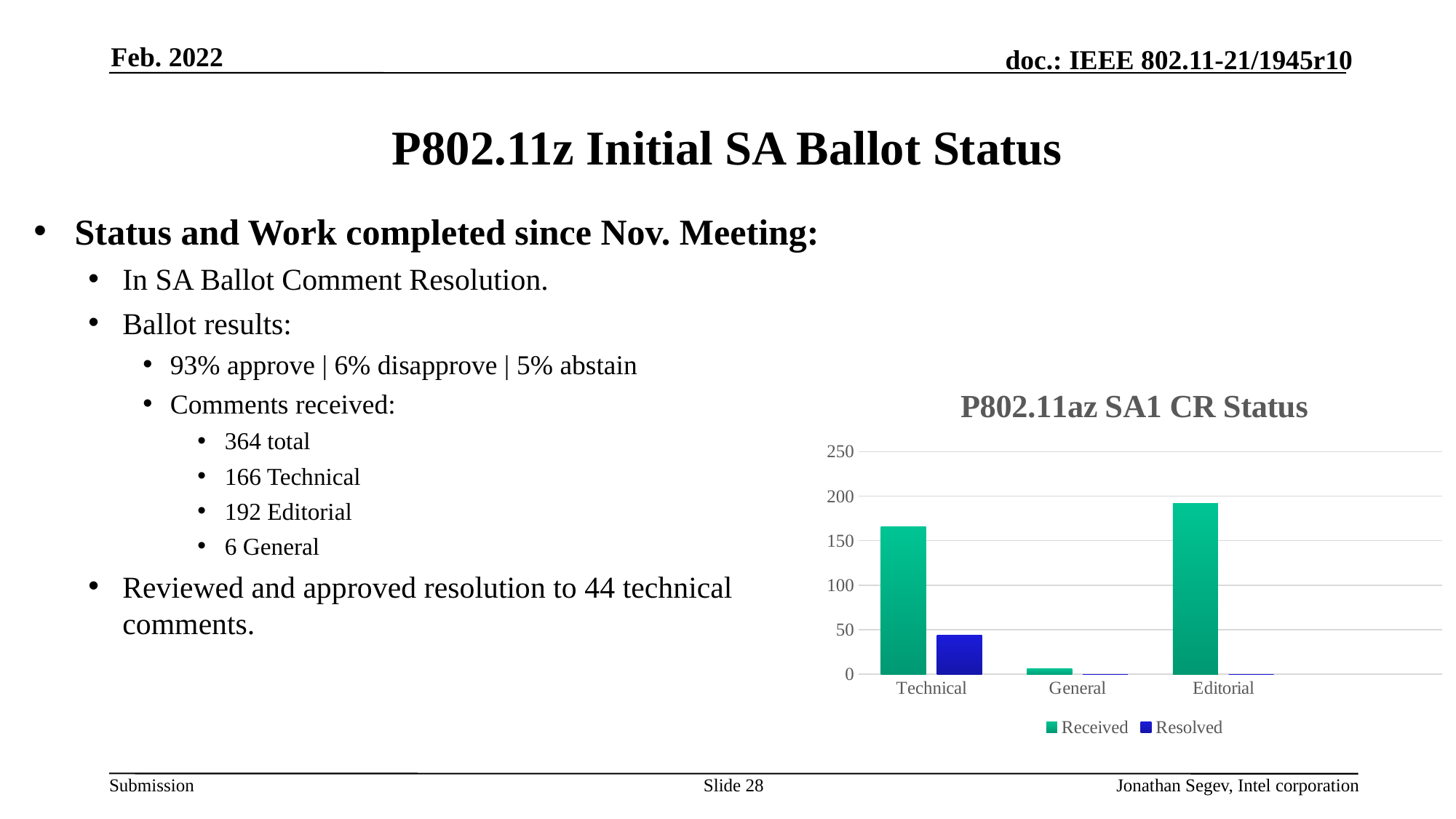
Which category has the lowest Received value? General Which series is shown in blue in the chart? Resolved Which category has the highest Received value? Editorial What is the title of the chart? P802.11az SA1 CR Status What kind of chart is shown on the slide? bar chart Is the Received value for General greater or less than 50? less Which category has the highest Resolved value? Technical Which is larger, the Received value for Editorial or the Received value for Technical? Editorial How many categories are shown on the x axis of the chart? 3 Is the Resolved value for Technical greater or less than 50? less How many series does the chart legend list? 2 Is the Received value for Technical greater or less than 150? greater